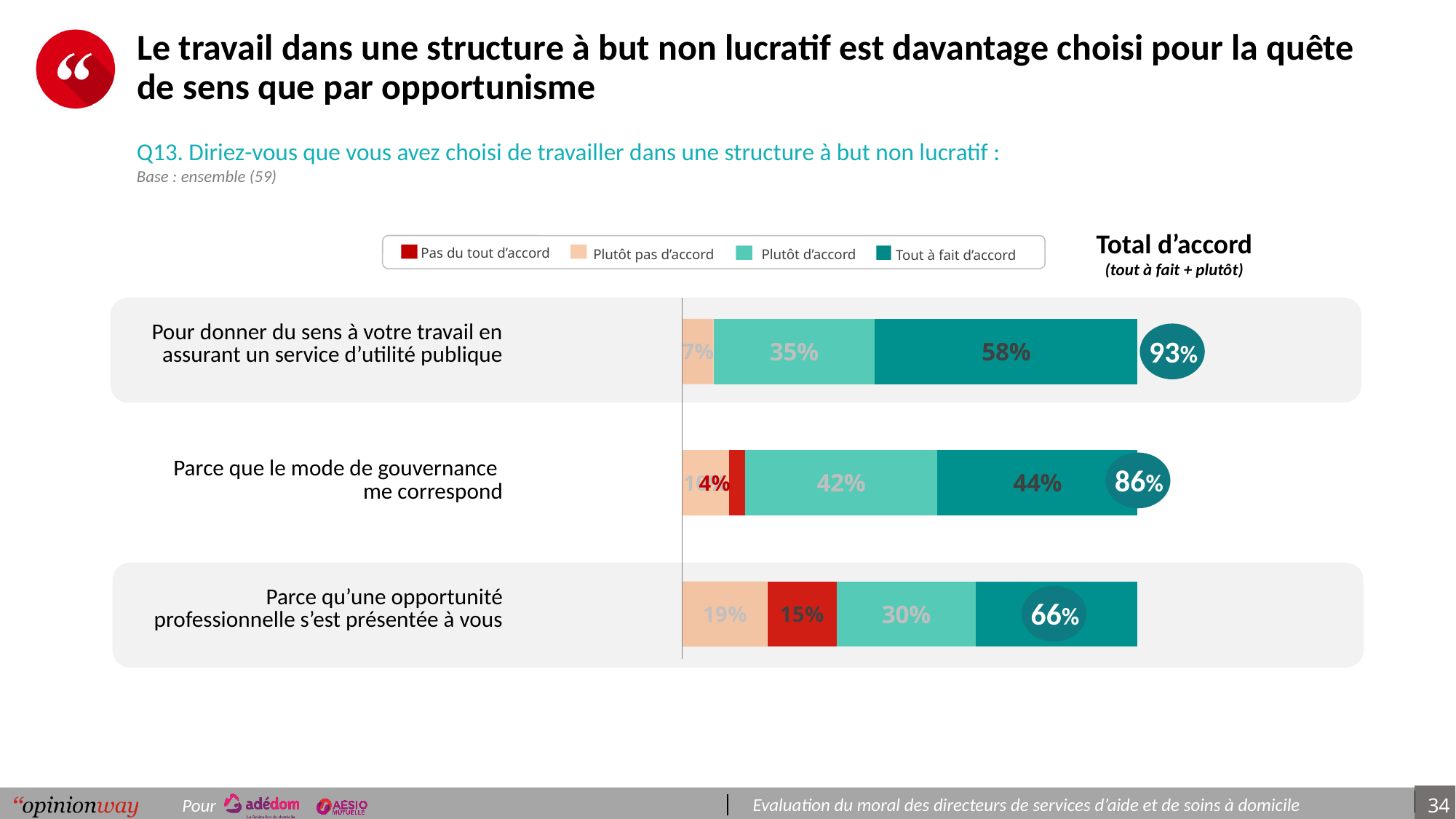
What is the 'Plutôt d'accord' value for 'Parce que le mode de gouvernance me correspond'? 42% Which legend entry is shown in red? Pas du tout d'accord What is the 'Pas du tout d'accord' value for 'Parce qu'une opportunité professionnelle s'est présentée à vous'? 15% What kind of chart is shown on the slide? Stacked bar chart What is the difference between the 'Total d'accord' for 'Pour donner du sens à votre travail' (93%) and for 'Parce qu'une opportunité professionnelle s'est présentée à vous' (66%)? 27 percentage points How many series does the legend list? 4 How many statements (categories) are plotted in the chart? 3 What is the 'Total d'accord' for 'Parce que le mode de gouvernance me correspond'? 86% Which statement has the lowest 'Total d'accord'? Parce qu'une opportunité professionnelle s'est présentée à vous Which statement has the highest 'Total d'accord'? Pour donner du sens à votre travail en assurant un service d'utilité publique What is the 'Tout à fait d'accord' value for 'Pour donner du sens à votre travail en assurant un service d'utilité publique'? 58% Which is larger: the 'Tout à fait d'accord' value for 'Pour donner du sens à votre travail' or for 'Parce que le mode de gouvernance me correspond'? Pour donner du sens à votre travail (58%)